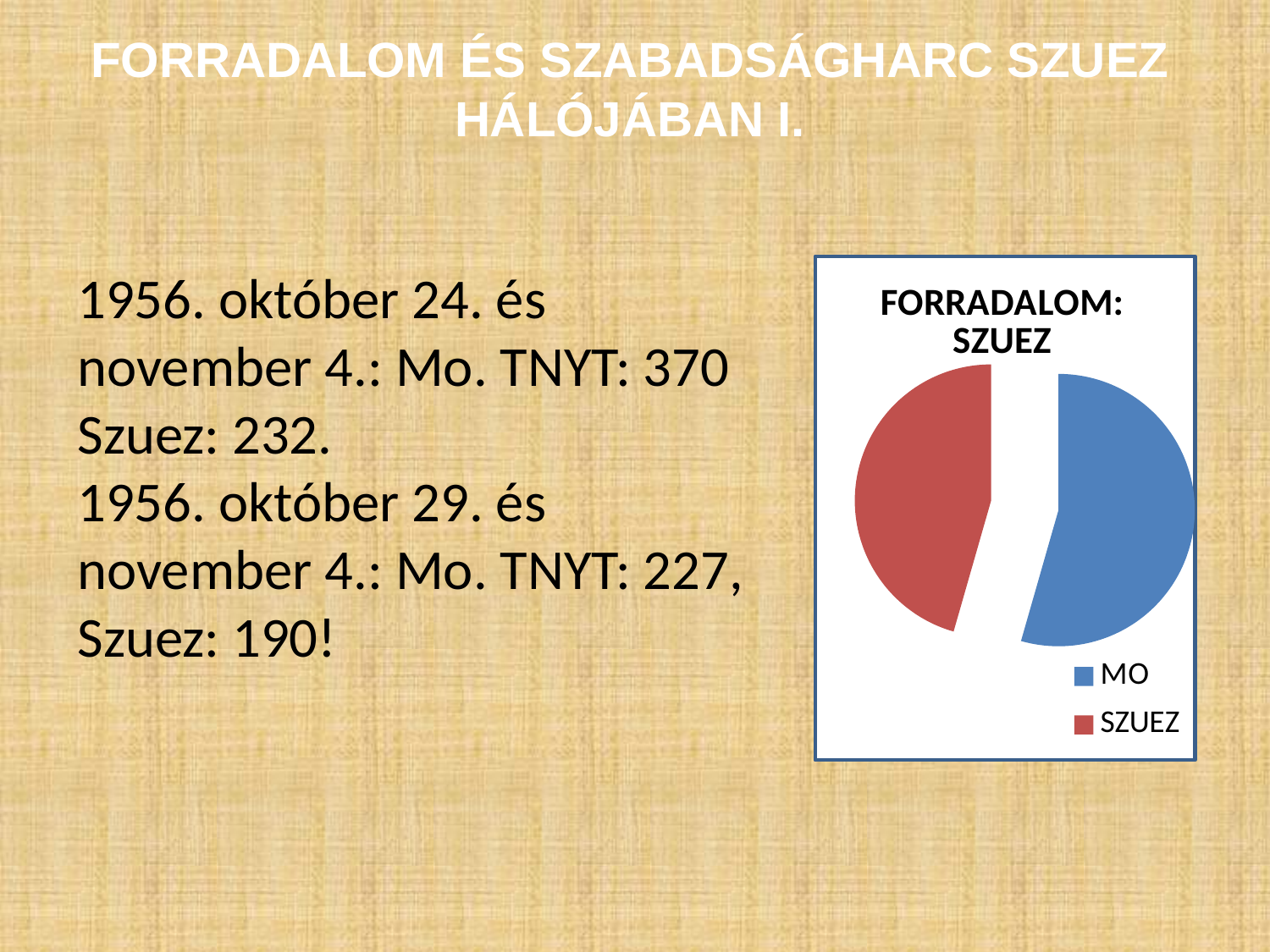
Which slice of the pie chart is the largest? MO How many slices does the pie chart have? 2 Which legend entry is shown in red in the pie chart? SZUEZ What is the title of the pie chart? FORRADALOM: SZUEZ Which slice of the pie chart is the smallest? SZUEZ How many entries does the legend of the pie chart list? 2 What kind of chart is shown on the slide? Pie chart What colour is the MO slice in the pie chart? Blue In the pie chart, which slice is larger, MO or SZUEZ? MO